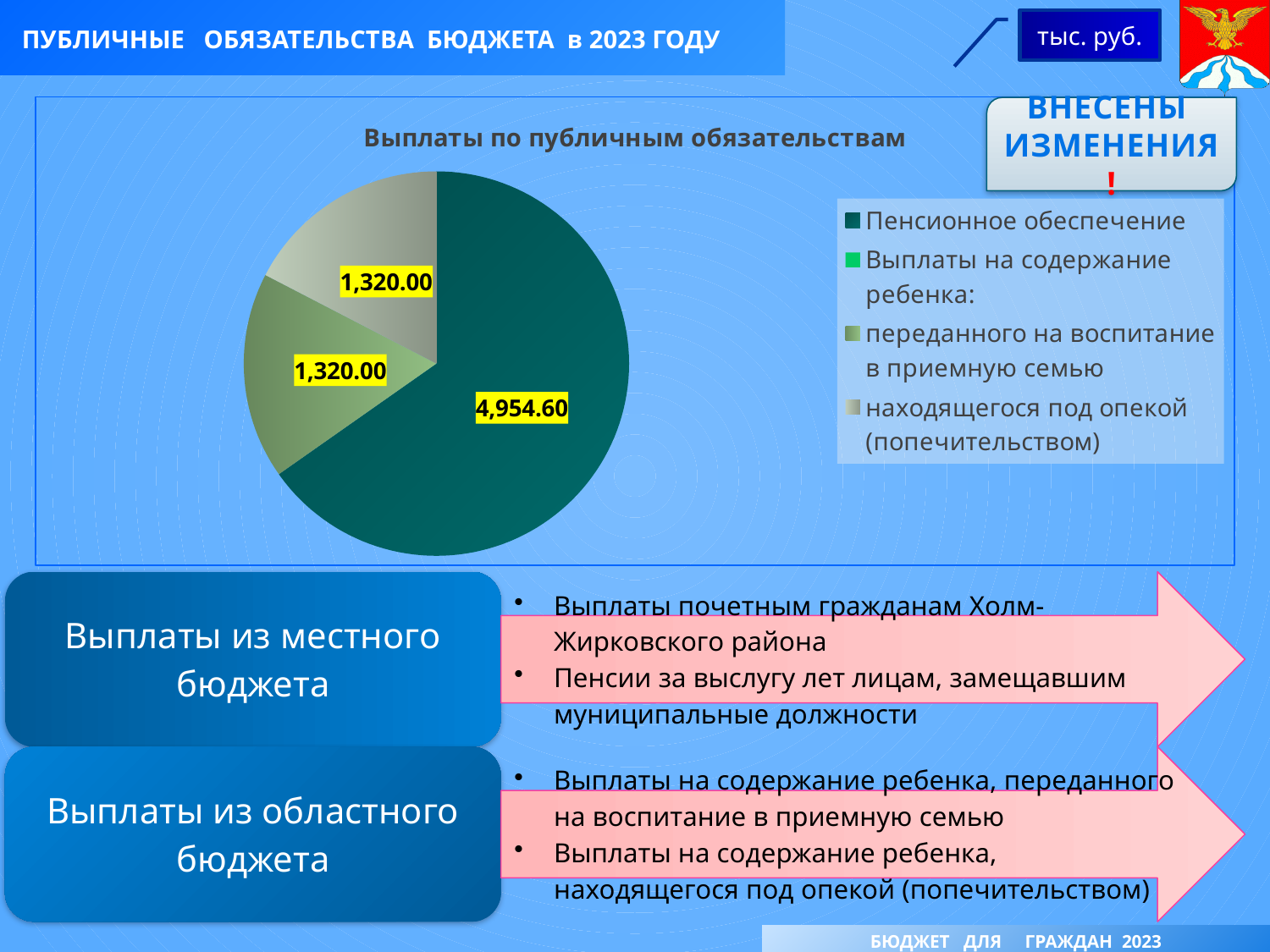
What is the value for Пенсионное обеспечение in the pie chart? 4,954.60 Which category has the largest slice in the pie chart? Пенсионное обеспечение What is the difference between the value for Пенсионное обеспечение and the value for 'переданного на воспитание в приемную семью'? 3,634.60 How many labelled slices are visible in the pie chart? 3 How many entries does the legend of the pie chart list? 4 In what units are the values of the pie chart given, according to the slide? тыс. руб. What kind of chart is shown on the slide? Pie chart What is the value for the slice 'находящегося под опекой (попечительством)'? 1,320.00 What is the total of the three labelled slices in the pie chart? 7,594.60 What is the value for the slice 'переданного на воспитание в приемную семью'? 1,320.00 Which is larger: the value for Пенсионное обеспечение or the value for 'находящегося под опекой (попечительством)'? Пенсионное обеспечение What is the title of the pie chart? Выплаты по публичным обязательствам